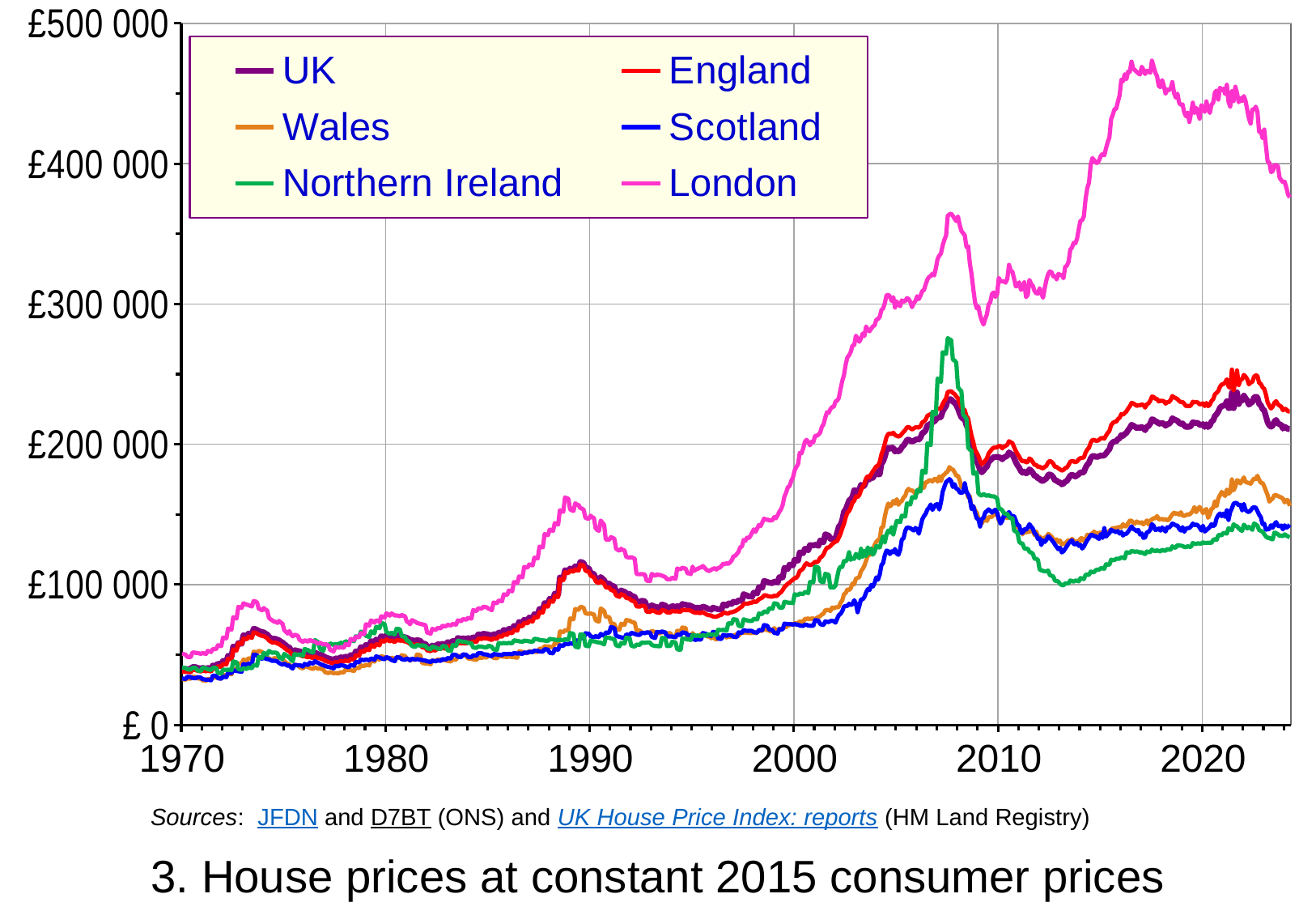
Is the value for England around 2020 greater or less than £200 000? greater How many series does the legend list? 6 What is the title of the chart? 3. House prices at constant 2015 consumer prices Which series reaches the highest value on the chart? London Overall, do the values for London rise or fall between 1970 and 2020? rise What kind of chart is shown on the slide? line chart Is the value for Northern Ireland around 2013 greater or less than £200 000? less Around 2020, which is larger, the value for London or the value for Wales? London What colour is the line for Scotland in the legend? blue Is the value for Scotland around 1990 greater or less than £100 000? less Around 2013, which is lower, the value for Northern Ireland or the value for England? Northern Ireland